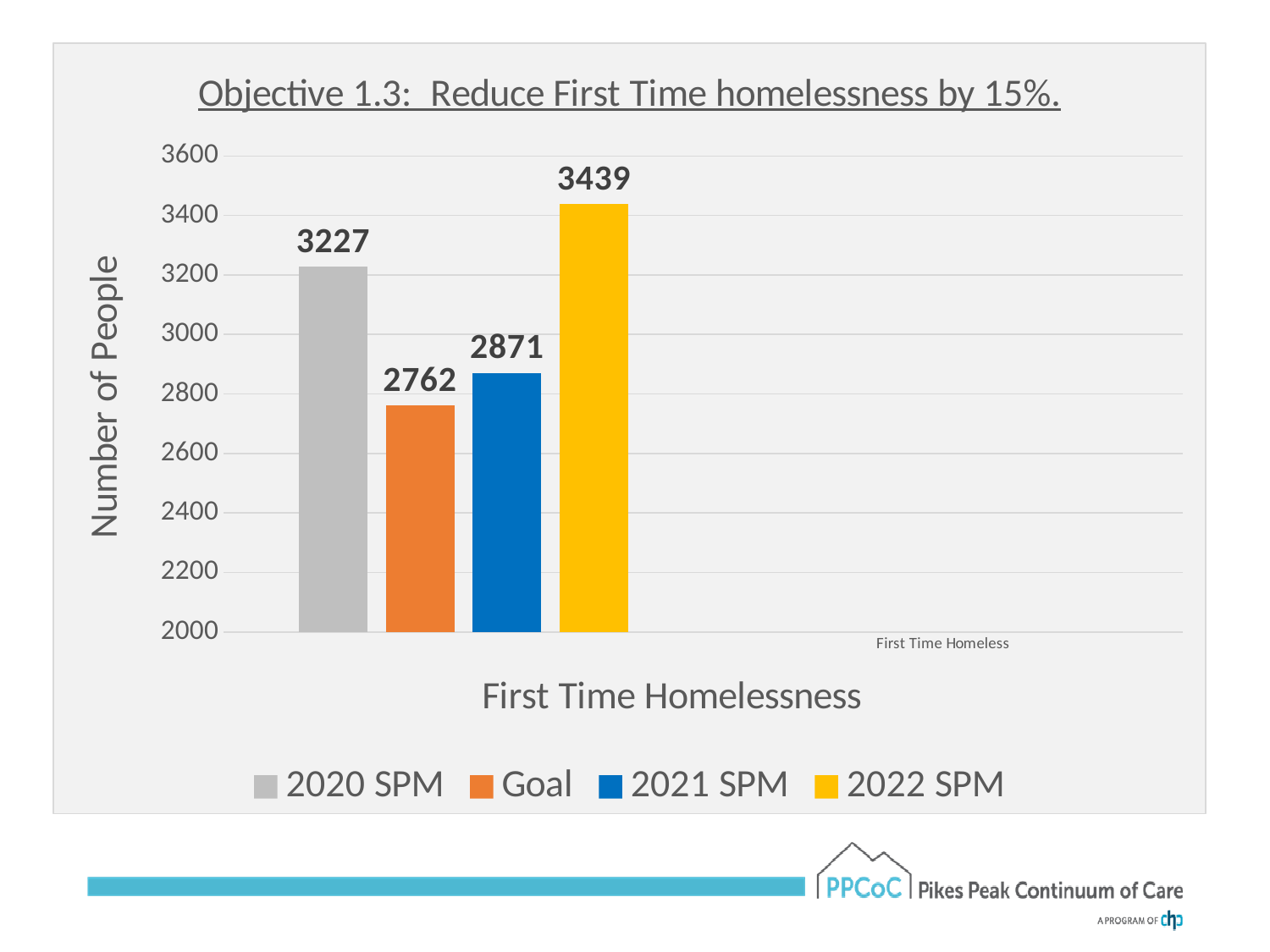
What is the difference between the 2020 SPM value and the 2021 SPM value? 356 Which series has the lowest value? Goal What is the value for 2021 SPM? 2871 Which is larger, the 2021 SPM value or the 2020 SPM value? 2020 SPM What is the value for 2020 SPM? 3227 Which series has the highest value? 2022 SPM What is the title of the chart? Objective 1.3: Reduce First Time homelessness by 15%. What kind of chart is shown on the slide? Bar chart How many series does the legend list? 4 What is the value for 2022 SPM? 3439 What is the difference between the 2022 SPM value and the Goal value? 677 What is the value for the Goal series? 2762